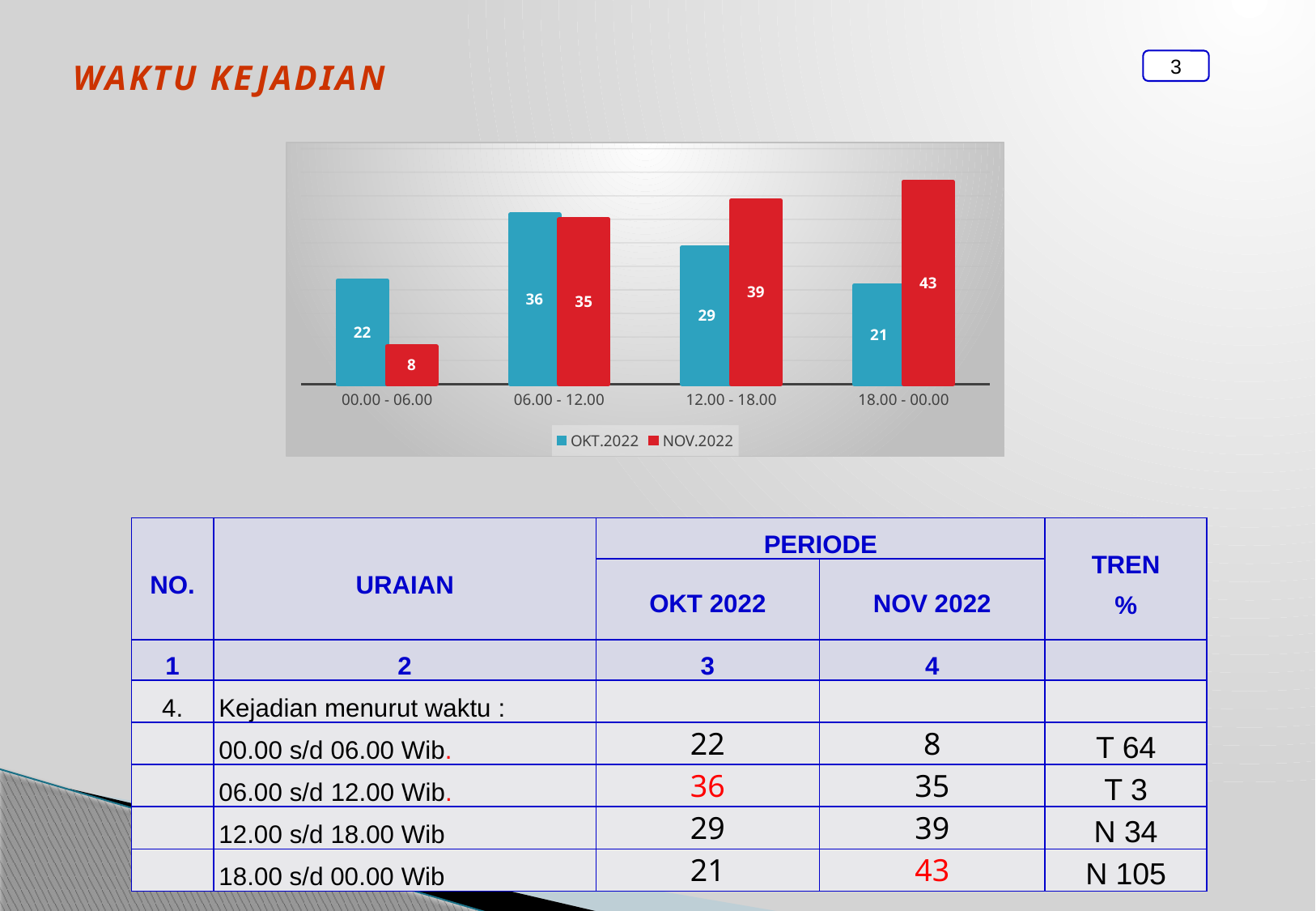
What is the NOV.2022 value for the 06.00 - 12.00 time period? 35 Which time period has the lowest NOV.2022 value? 00.00 - 06.00 How many series does the chart legend list? 2 What is the NOV.2022 value for the 18.00 - 00.00 time period? 43 What is the difference between the OKT.2022 and NOV.2022 values for the 00.00 - 06.00 period? 14 Which time period has the highest NOV.2022 value? 18.00 - 00.00 For the 12.00 - 18.00 period, which series has the larger value, OKT.2022 or NOV.2022? NOV.2022 What is the OKT.2022 value for the 00.00 - 06.00 time period? 22 What is the difference between the NOV.2022 and OKT.2022 values for the 18.00 - 00.00 period? 22 How many time periods are shown on the x axis of the chart? 4 Which time period has the lowest OKT.2022 value? 18.00 - 00.00 What kind of chart is shown on the slide? Bar chart